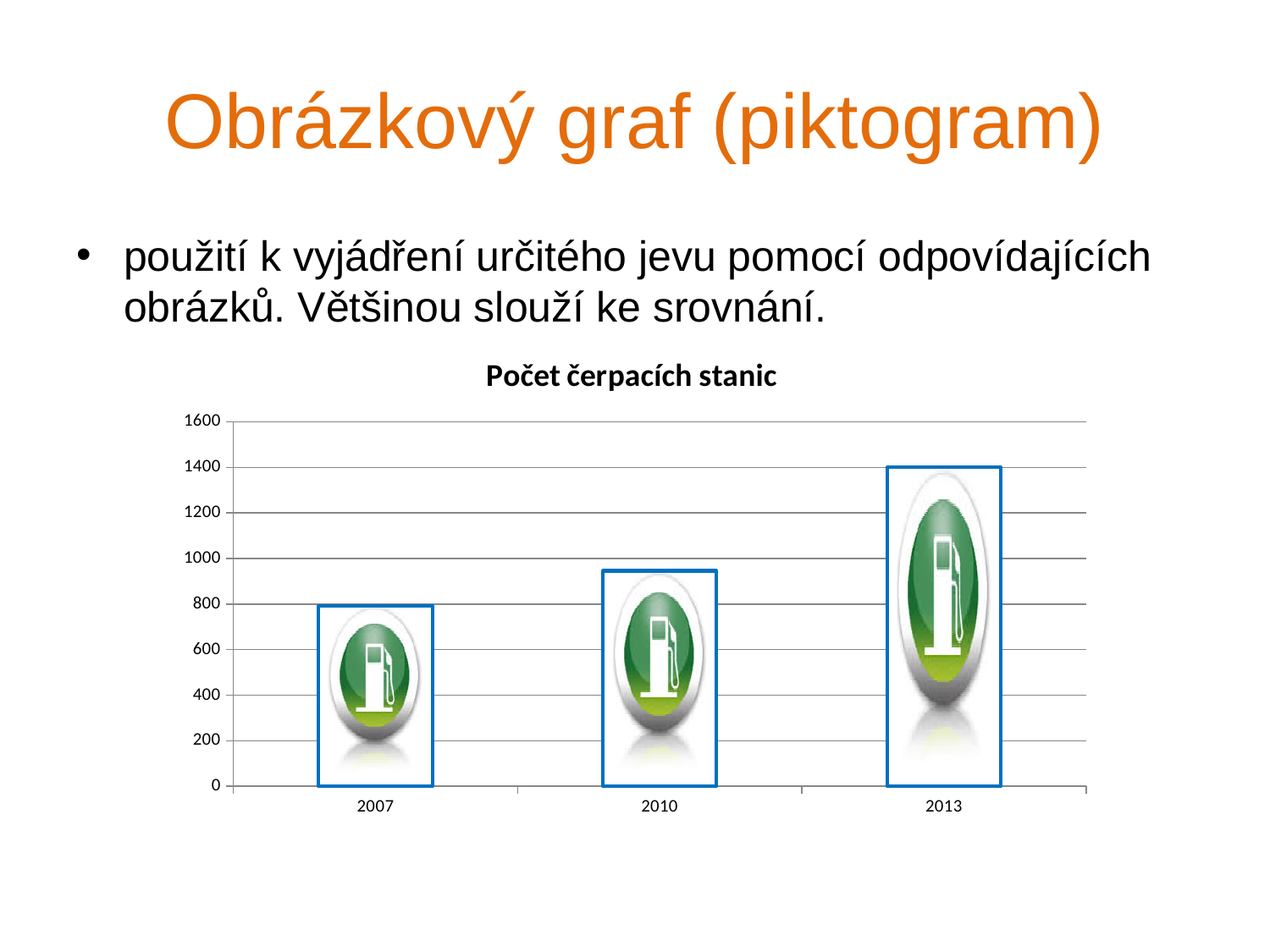
Which year has the lowest value in the chart? 2007 What is the highest value shown on the y axis of the chart? 1600 Is the value for 2010 greater or less than 1000? less Is the value for 2010 greater or less than 800? greater What is the title of the chart? Počet čerpacích stanic How many categories (years) are shown on the x axis of the chart? 3 Is the value for 2013 greater or less than 1200? greater Which is larger, the value for 2010 or the value for 2013? 2013 Do the values rise or fall from 2007 to 2013? rise What kind of chart is shown on the slide? bar chart (pictogram) Which year has the highest value in the chart? 2013